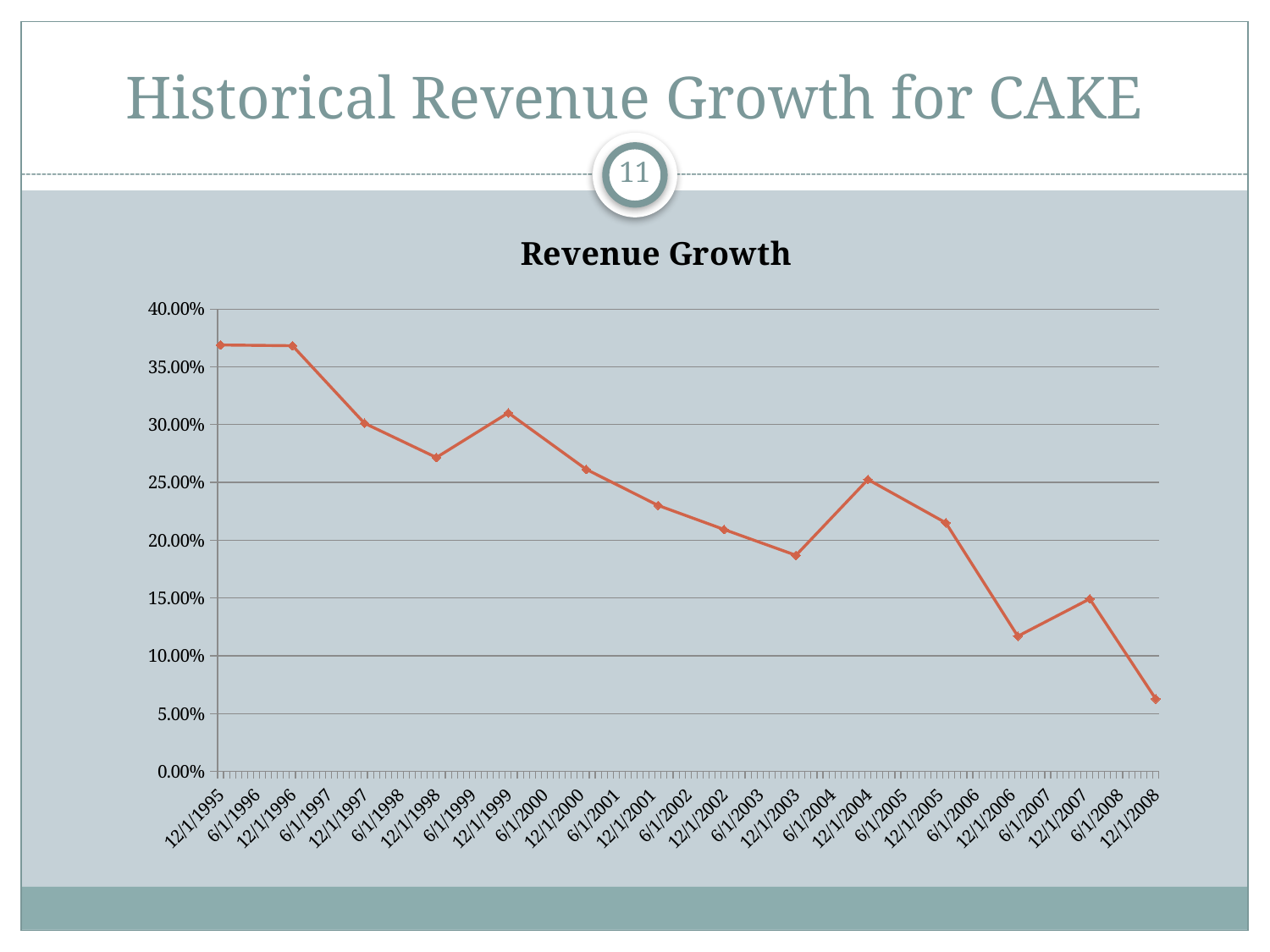
Which date has the lowest revenue growth value? 12/1/2008 Is the revenue growth value for 12/1/1995 greater or less than 35.00%? greater Is the revenue growth value for 12/1/2008 greater or less than 10.00%? less How many data points are plotted on the line? 14 Which has the larger revenue growth value, 12/1/2006 or 12/1/2007? 12/1/2007 What kind of chart is shown on the slide? line chart Is the revenue growth value for 12/1/2003 greater or less than 20.00%? less Overall, do the revenue growth values rise or fall from 12/1/1995 to 12/1/2008? fall What is the title of the chart? Revenue Growth Which has the larger revenue growth value, 12/1/1998 or 12/1/1999? 12/1/1999